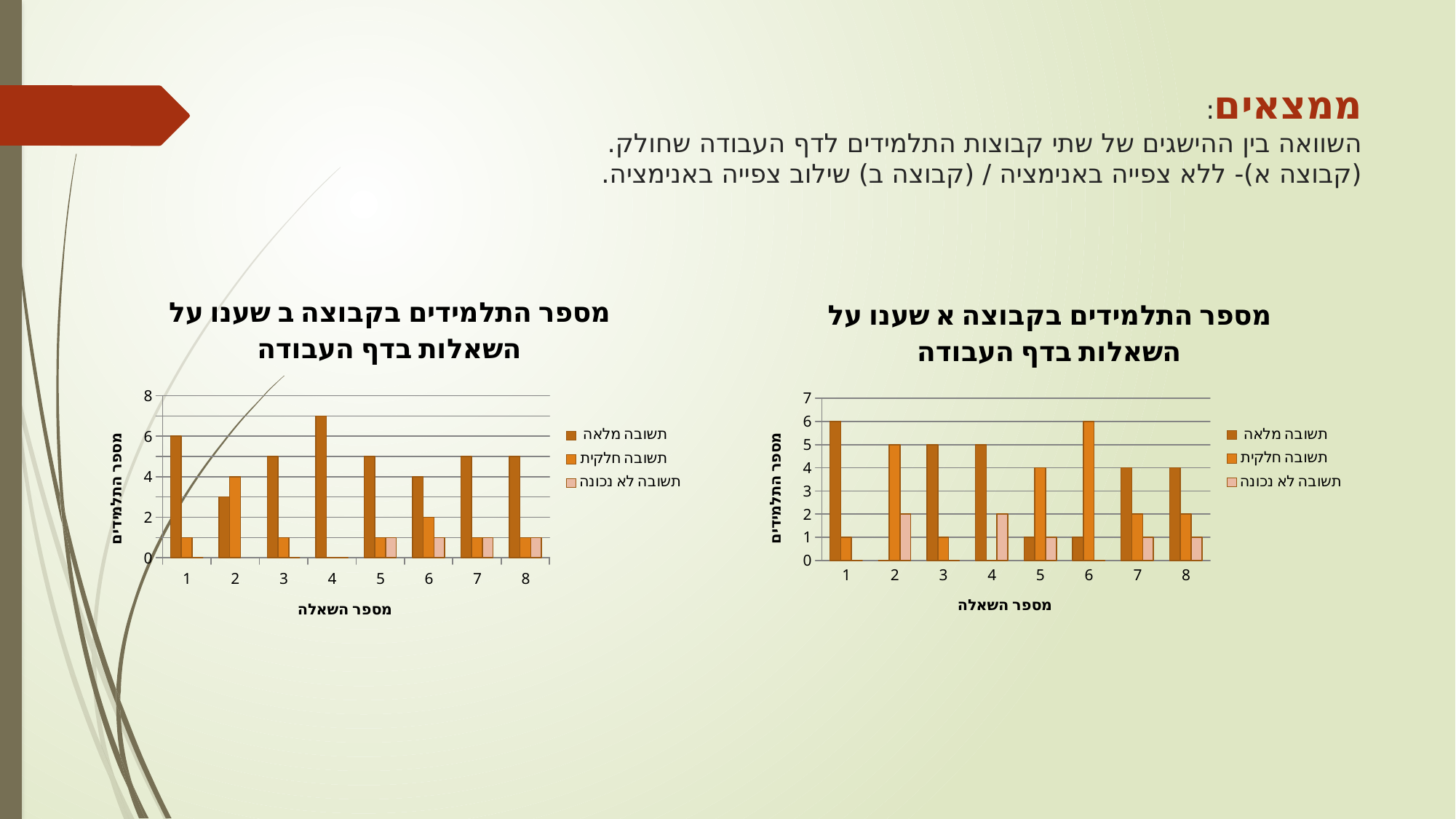
What is the label of the x axis on the left chart (group ב)? מספר השאלה What kind of chart is the right chart (group א)? bar chart How many questions (x-axis categories) are shown in the right chart (group א)? 8 In the right chart (group א), what is the value of the תשובה לא נכונה series for question 2? 2 How many series does the legend of the left chart (group ב) list? 3 In the left chart (group ב), is the תשובה מלאה value for question 1 greater or less than 4? greater In the right chart (group א), which question has the highest תשובה חלקית value? 6 In the left chart (group ב), what is the difference between the תשובה מלאה value for question 1 and for question 2? 3 In the right chart (group א), which is larger for question 5: תשובה מלאה or תשובה חלקית? תשובה חלקית In the right chart (group א), what is the value of the תשובה חלקית series for question 6? 6 In the left chart (group ב), which question has the highest תשובה מלאה value? 4 In the left chart (group ב), what is the value of the תשובה מלאה series for question 4? 7